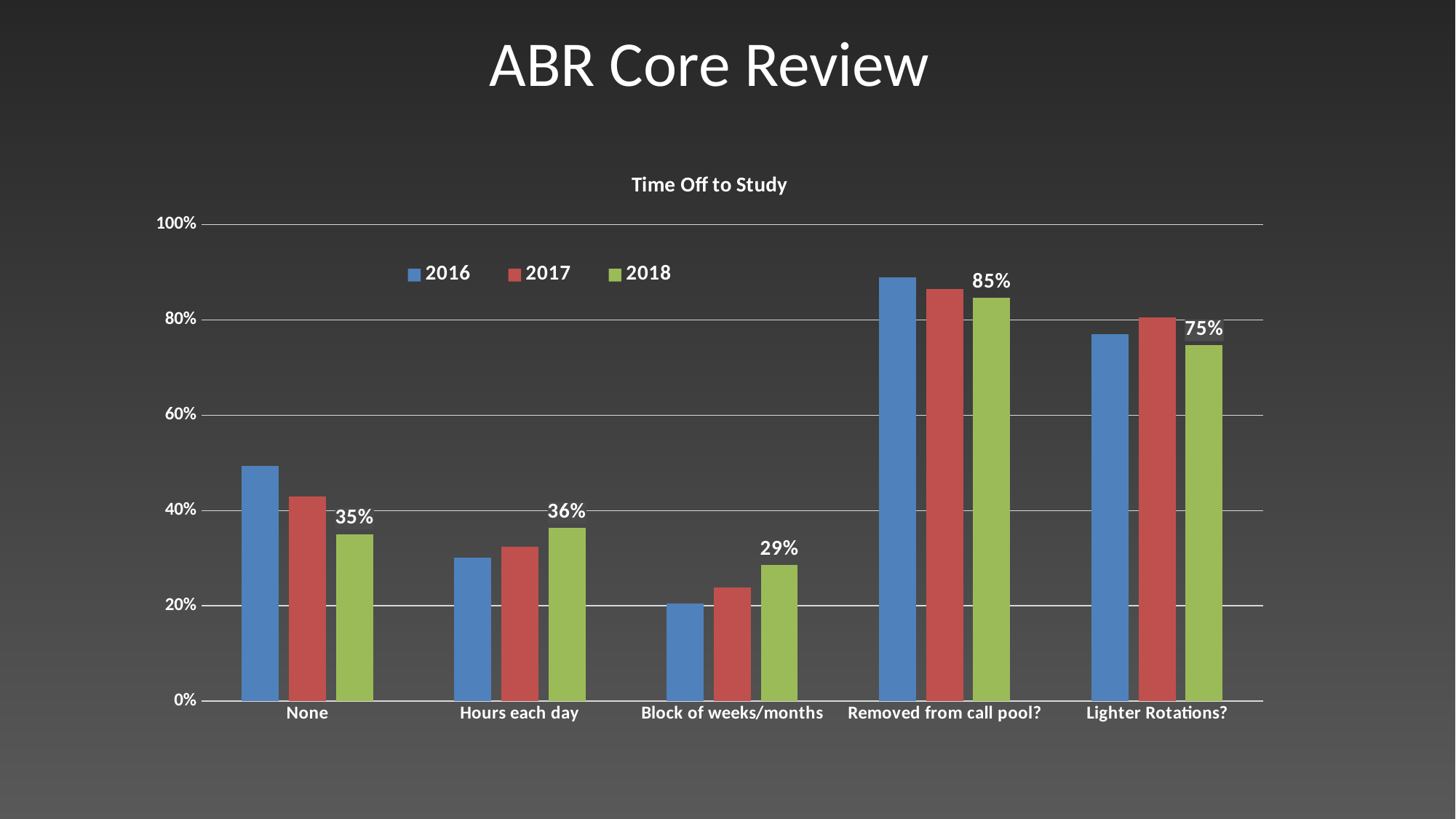
Among the 2018 values, which category is lowest? Block of weeks/months How many categories are shown on the x axis? 5 What is the difference between the 2018 values for Removed from call pool? and Lighter Rotations? 10 percentage points Is the 2016 value for Block of weeks/months greater or less than 40%? less What is the title of the chart? Time Off to Study What is the value for 2018 in the Block of weeks/months category? 29% Is the 2016 value for Removed from call pool? greater or less than 80%? greater What is the value for 2018 in the Removed from call pool? category? 85% Among the 2018 values, which category is highest? Removed from call pool? What is the value for 2018 in the None category? 35% How many series does the legend list? 3 In the None category, which is larger: the 2016 value or the 2018 value? 2016